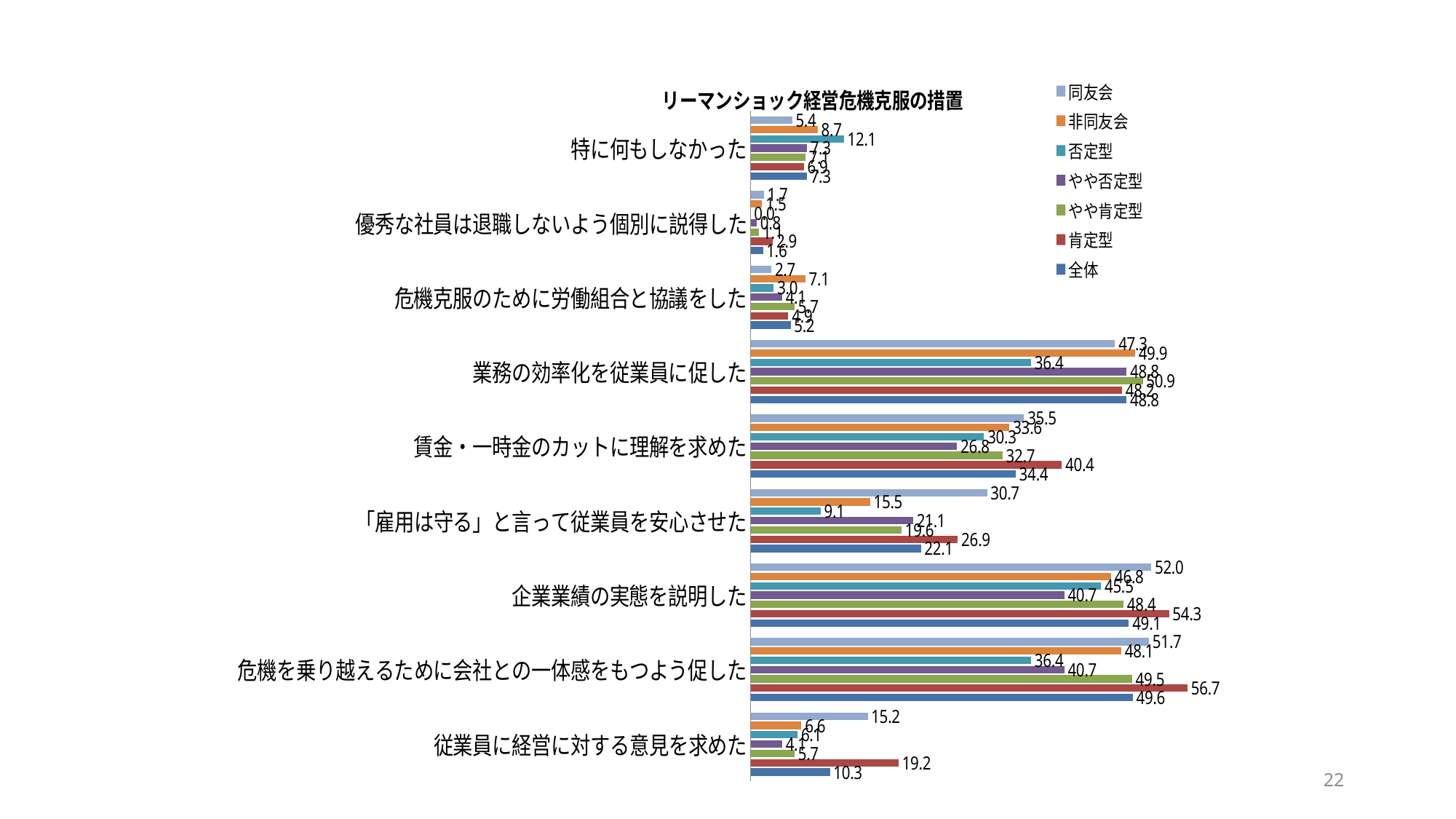
What is the difference between 同友会 and 非同友会 in the category 企業業績の実態を説明した? 5.2 What is the title of the chart? リーマンショック経営危機克服の措置 What is the value for 全体 in the category 企業業績の実態を説明した? 49.1 What is the value for 肯定型 in the category 危機を乗り越えるために会社との一体感をもつよう促した? 56.7 How many categories (measures) are shown on the chart? 9 What is the value for 否定型 in the category 特に何もしなかった? 12.1 What kind of chart is shown on the slide? bar chart Which series has the lowest value in the category 賃金・一時金のカットに理解を求めた? やや否定型 Which series has the highest value in the category 「雇用は守る」と言って従業員を安心させた? 同友会 In the category 業務の効率化を従業員に促した, which is larger: 非同友会 or 否定型? 非同友会 How many series does the legend list? 7 What is the difference between 肯定型 and 同友会 in the category 従業員に経営に対する意見を求めた? 4.0